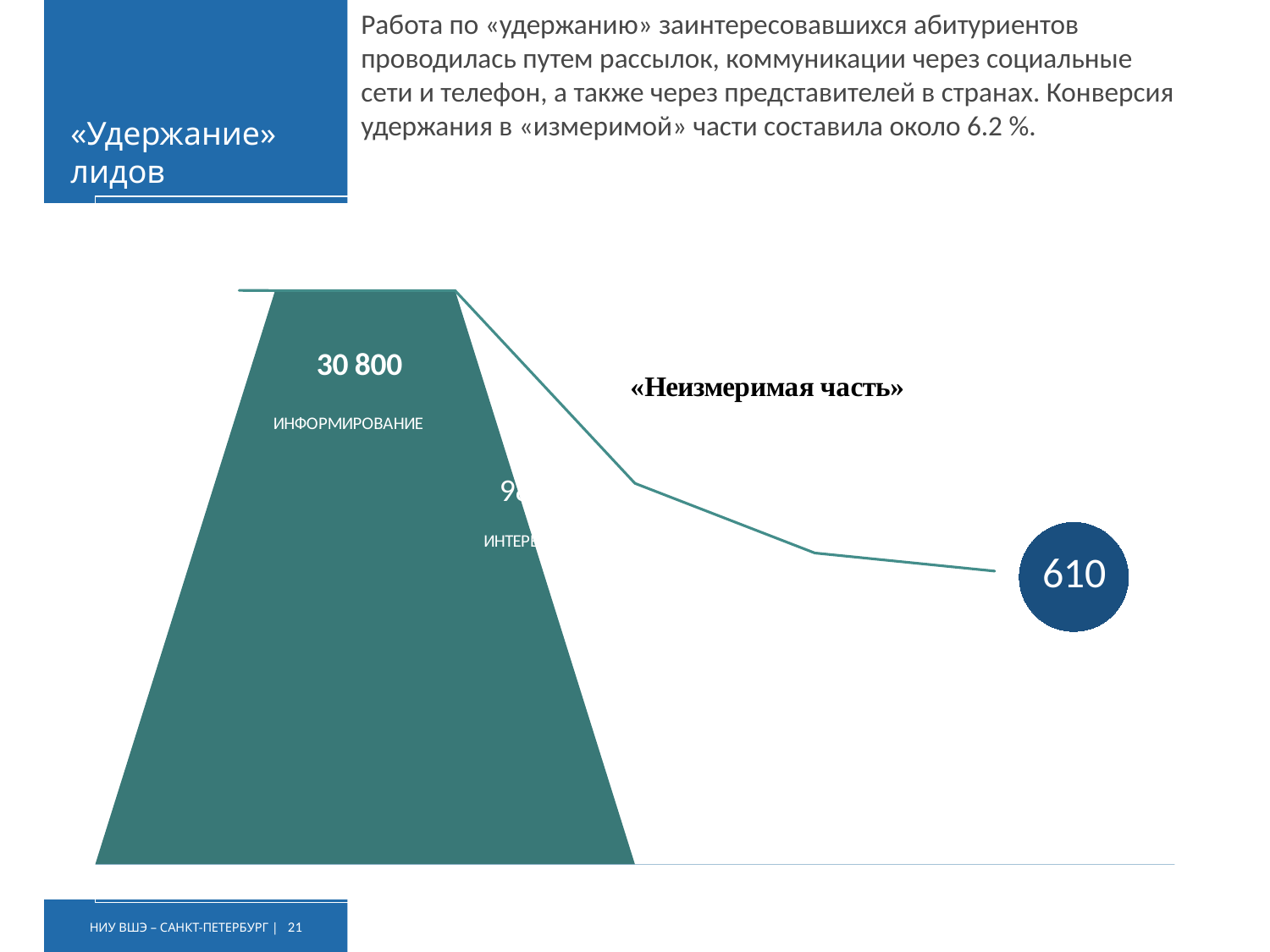
Do the values decrease or increase from the top of the funnel to the blue circle? decrease What number is shown in the blue circle at the end of the line? 610 What value is shown for the ИНФОРМИРОВАНИЕ stage of the funnel? 30 800 What is the label of the top (widest) stage of the funnel? ИНФОРМИРОВАНИЕ What is the difference between the ИНФОРМИРОВАНИЕ value (30 800) and the value in the blue circle (610)? 30 190 What label is written in bold next to the descending line on the right side of the chart? «Неизмеримая часть» Is the value in the blue circle greater or less than 1 000? less Is the value for ИНФОРМИРОВАНИЕ greater or less than 30 000? greater Which is larger, the value for ИНФОРМИРОВАНИЕ or the value in the blue circle? ИНФОРМИРОВАНИЕ